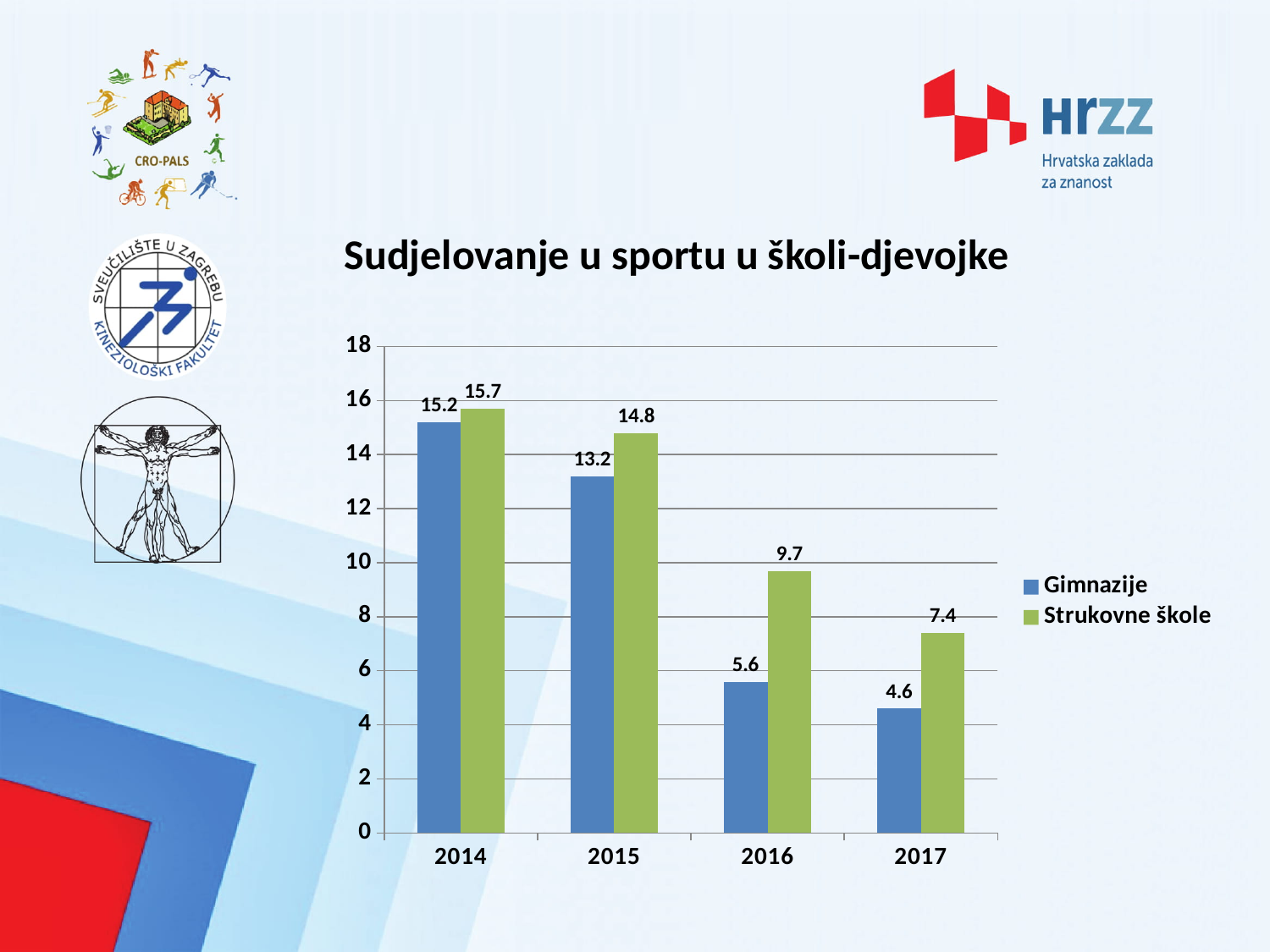
What is the value for Strukovne škole in 2016? 9.7 What is the value for Gimnazije in 2014? 15.2 Is the value for Strukovne škole in 2017 greater or less than 8? less Which year has the highest value for Strukovne škole? 2014 What kind of chart is shown on the slide? bar chart What is the value for Gimnazije in 2017? 4.6 Which year has the lowest value for Gimnazije? 2017 How many years are shown on the x axis? 4 How many series does the legend list? 2 Do the values for Gimnazije rise or fall from 2014 to 2017? fall What is the difference between Strukovne škole and Gimnazije in 2016? 4.1 Which is larger in 2015, Gimnazije or Strukovne škole? Strukovne škole